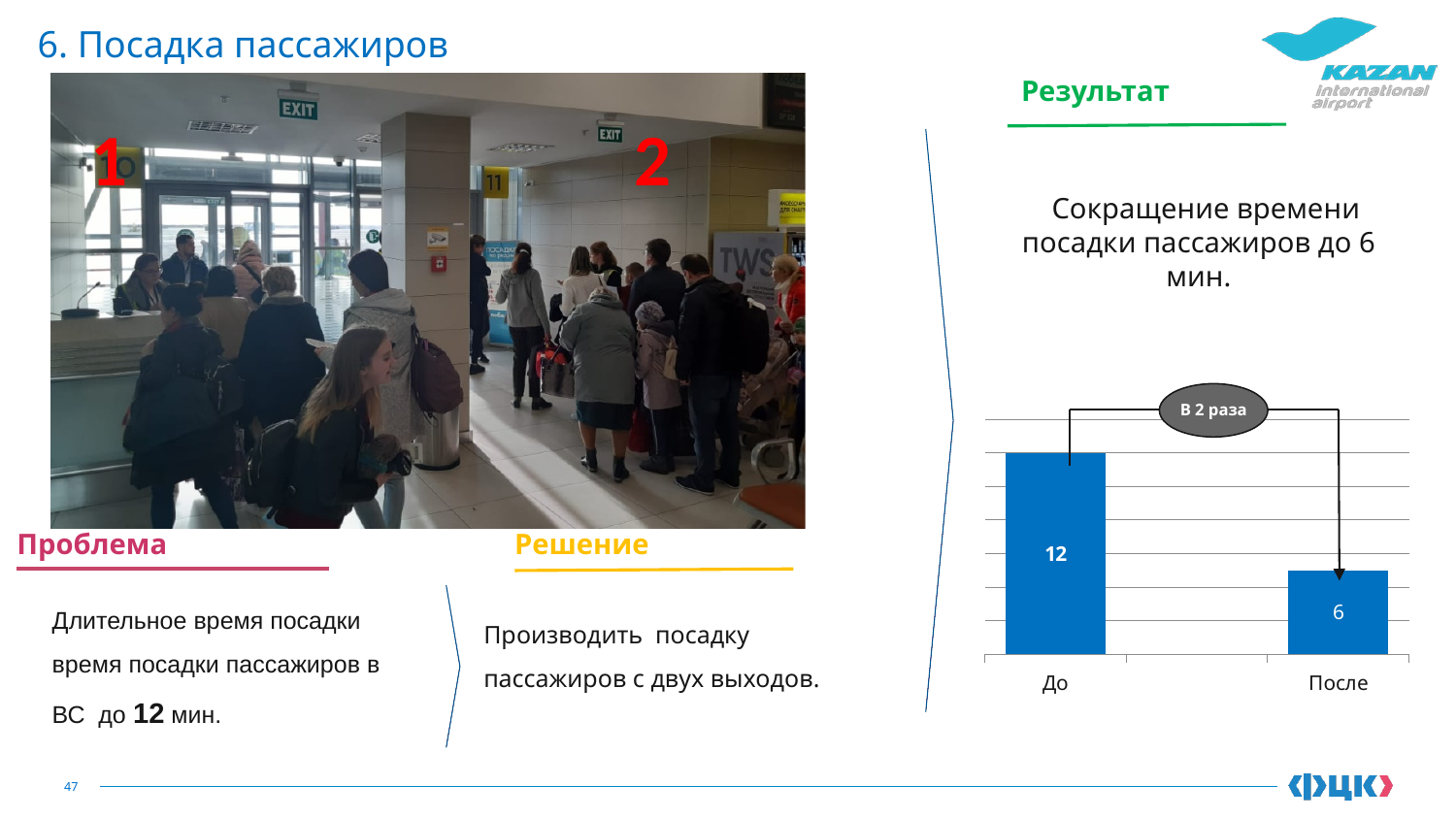
What kind of chart is shown on the slide? bar chart Which is larger, the value for "До" or the value for "После"? До What is the value for "После" in the bar chart? 6 How many categories are shown in the bar chart? 2 What is the value for "До" in the bar chart? 12 What is the difference between the values for "До" and "После"? 6 Which category has the highest value in the bar chart? До Do the values rise or fall from "До" to "После"? fall What colour are the bars in the chart? blue Which category has the lowest value in the bar chart? После What text is written in the oval label above the bars? В 2 раза